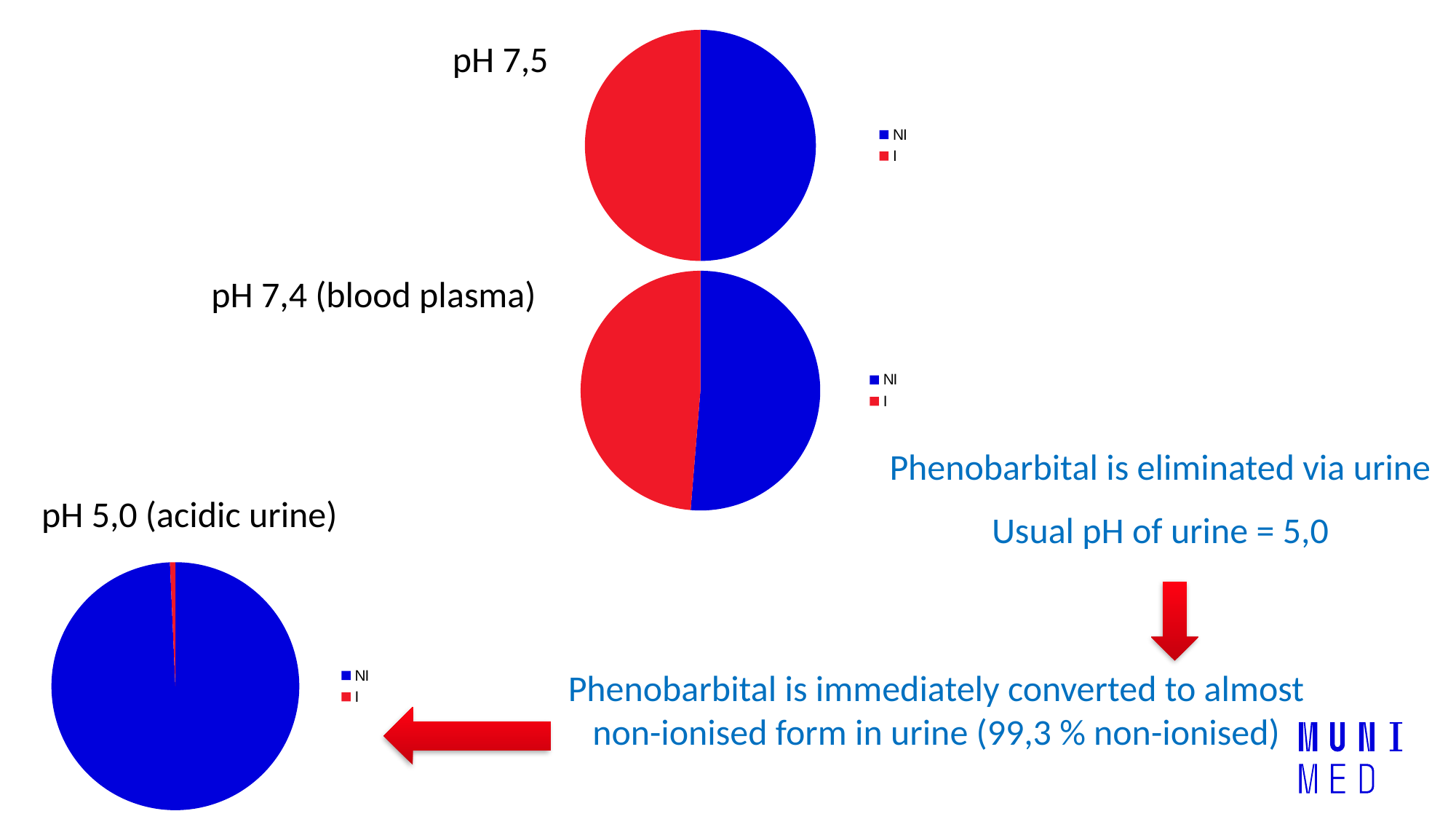
In the 'pH 5,0 (acidic urine)' chart, which category has the smallest slice? I What are the two legend entries of the 'pH 7,5' chart? NI and I In the 'pH 7,4 (blood plasma)' chart, what colour represents the I category? Red In the 'pH 5,0 (acidic urine)' chart, which category has the largest slice? NI What kind of chart is the 'pH 5,0 (acidic urine)' chart? Pie chart In the 'pH 5,0 (acidic urine)' chart, which slice is larger, NI or I? NI How many entries does the legend of the 'pH 7,4 (blood plasma)' chart list? 2 How many slices does the 'pH 5,0 (acidic urine)' pie chart have? 2 How many pie charts are shown on the slide? 3 What kind of chart is the 'pH 7,5' chart? Pie chart